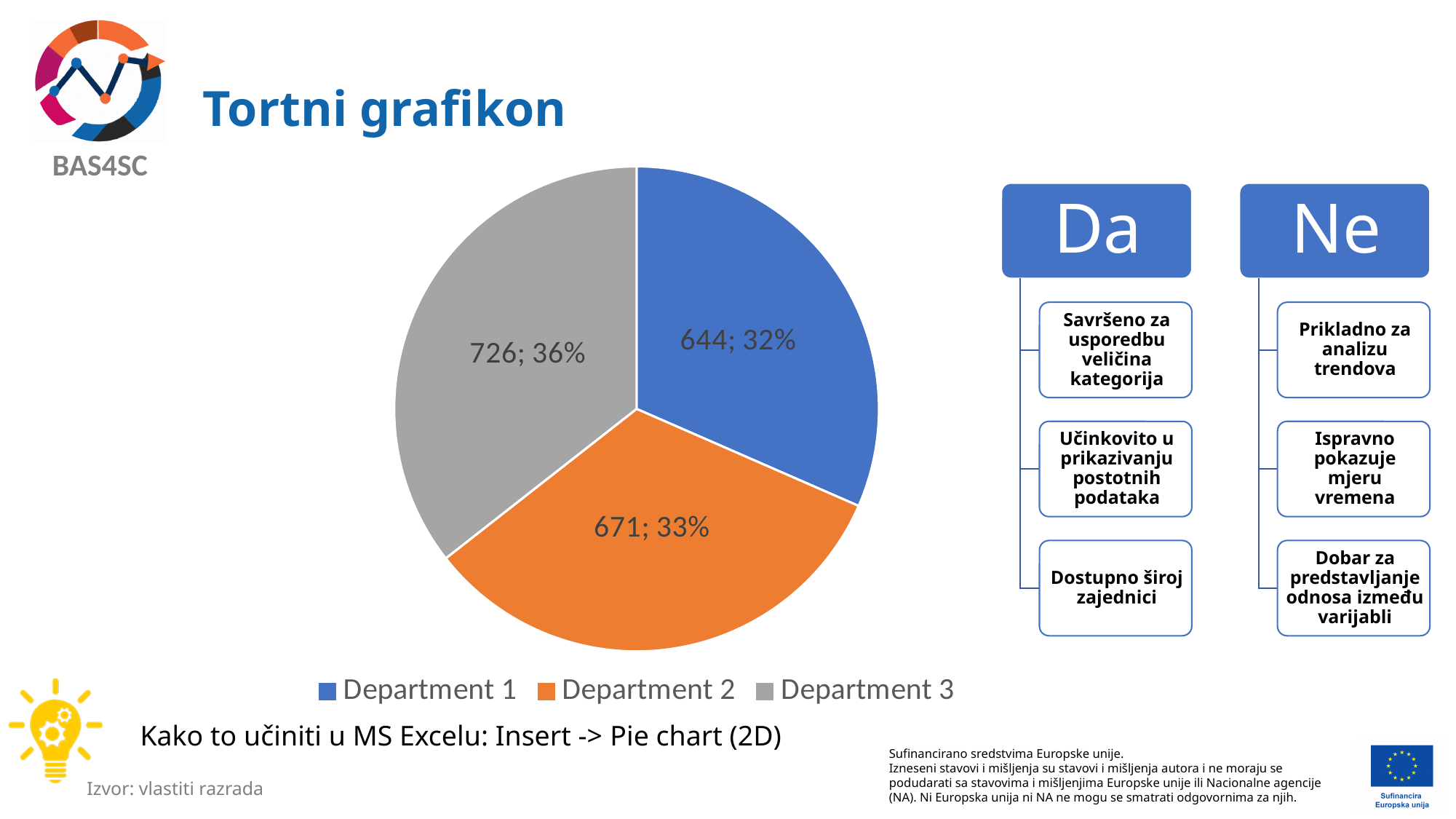
Which is larger, the value for Department 2 or Department 1? Department 2 What is the value for Department 1? 644 What share of the pie does Department 1 represent? 32% What is the difference between the values for Department 3 and Department 1? 82 What kind of chart is shown on the slide? pie chart What colour is the slice for Department 2? orange What is the value for Department 3? 726 What share of the pie does Department 3 represent? 36% What is the value for Department 2? 671 Which department has the smallest slice? Department 1 Which department has the largest slice? Department 3 How many slices does the pie chart have? 3